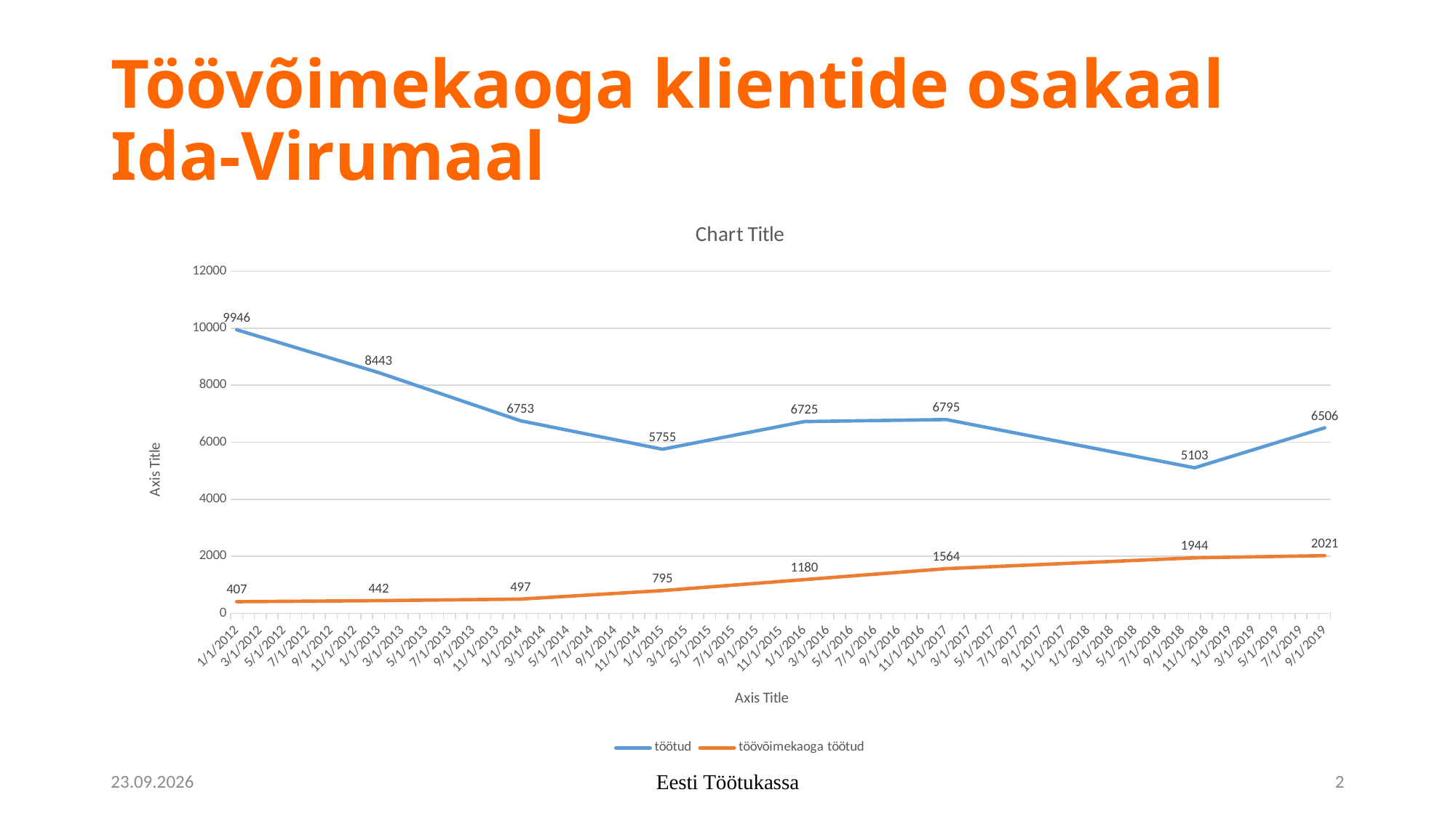
What is the highest labelled value of the töövõimekaoga töötud series? 2021 What is the highest labelled value of the töötud series? 9946 Does the töövõimekaoga töötud series rise or fall over the period shown? rise What kind of chart is shown on the slide? line chart What is the difference between the töötud and töövõimekaoga töötud values at 1/1/2012? 9539 What is the value of the töövõimekaoga töötud series at 1/1/2012? 407 What is the value of the töötud series at 1/1/2012? 9946 By how much did the töötud value fall from 1/1/2013 to 1/1/2014? 1690 What is the value of the töötud series at 1/1/2015? 5755 Which series is drawn in orange? töövõimekaoga töötud How many series does the legend list? 2 What is the lowest labelled value of the töötud series? 5103